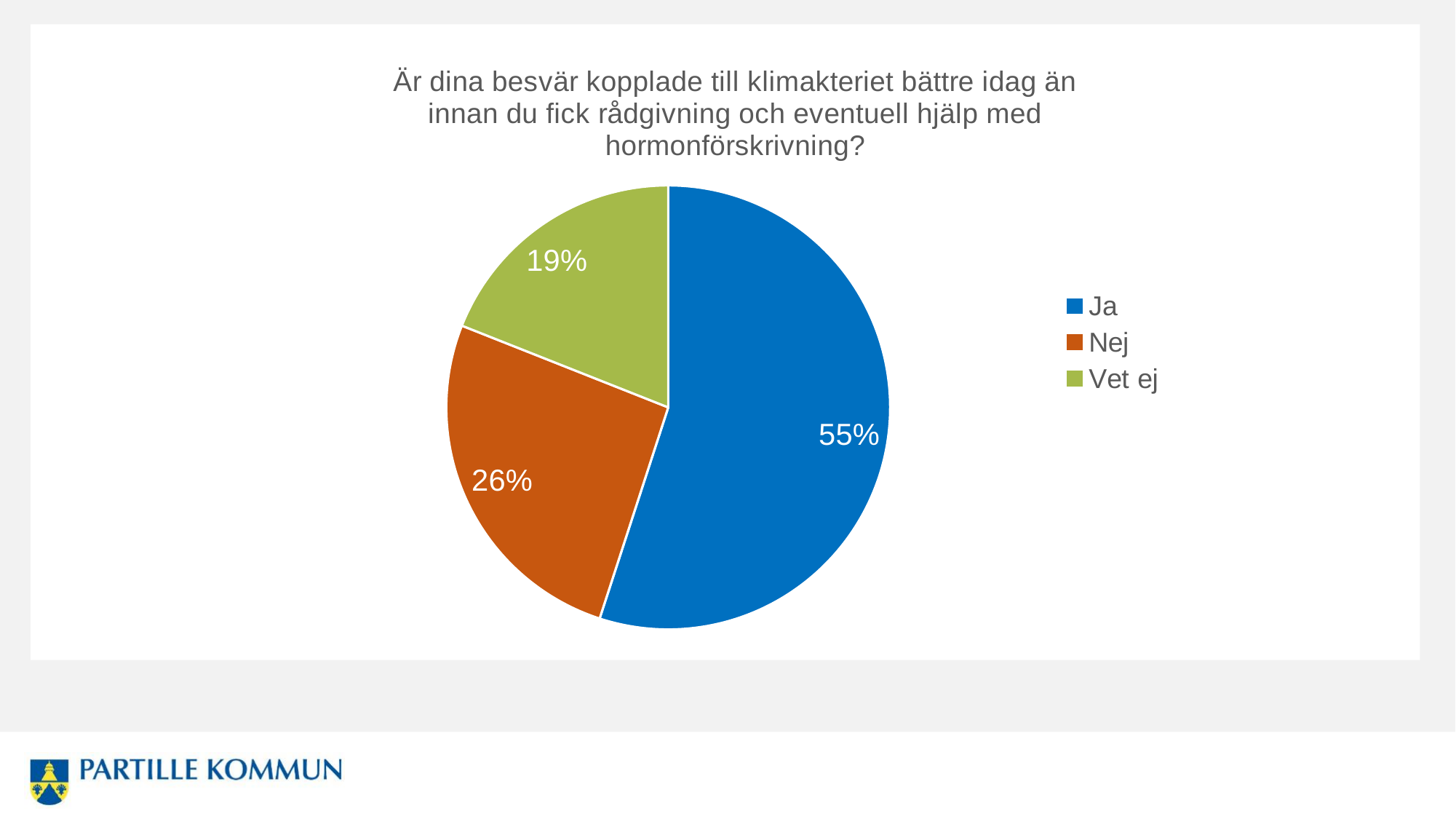
What colour is the slice for "Ja"? Blue What percentage of respondents answered "Nej"? 26% What is the difference in percentage points between "Nej" and "Vet ej"? 7 How many slices does the pie chart have? 3 Which answer has the smallest share of the pie? Vet ej Which answer has the largest share of the pie? Ja What is the difference in percentage points between "Ja" and "Nej"? 29 Which is larger, the share for "Nej" or the share for "Vet ej"? Nej What percentage of respondents answered "Vet ej"? 19% What are the three legend entries of the chart? Ja, Nej, Vet ej What percentage of respondents answered "Ja"? 55% What kind of chart is shown on the slide? Pie chart